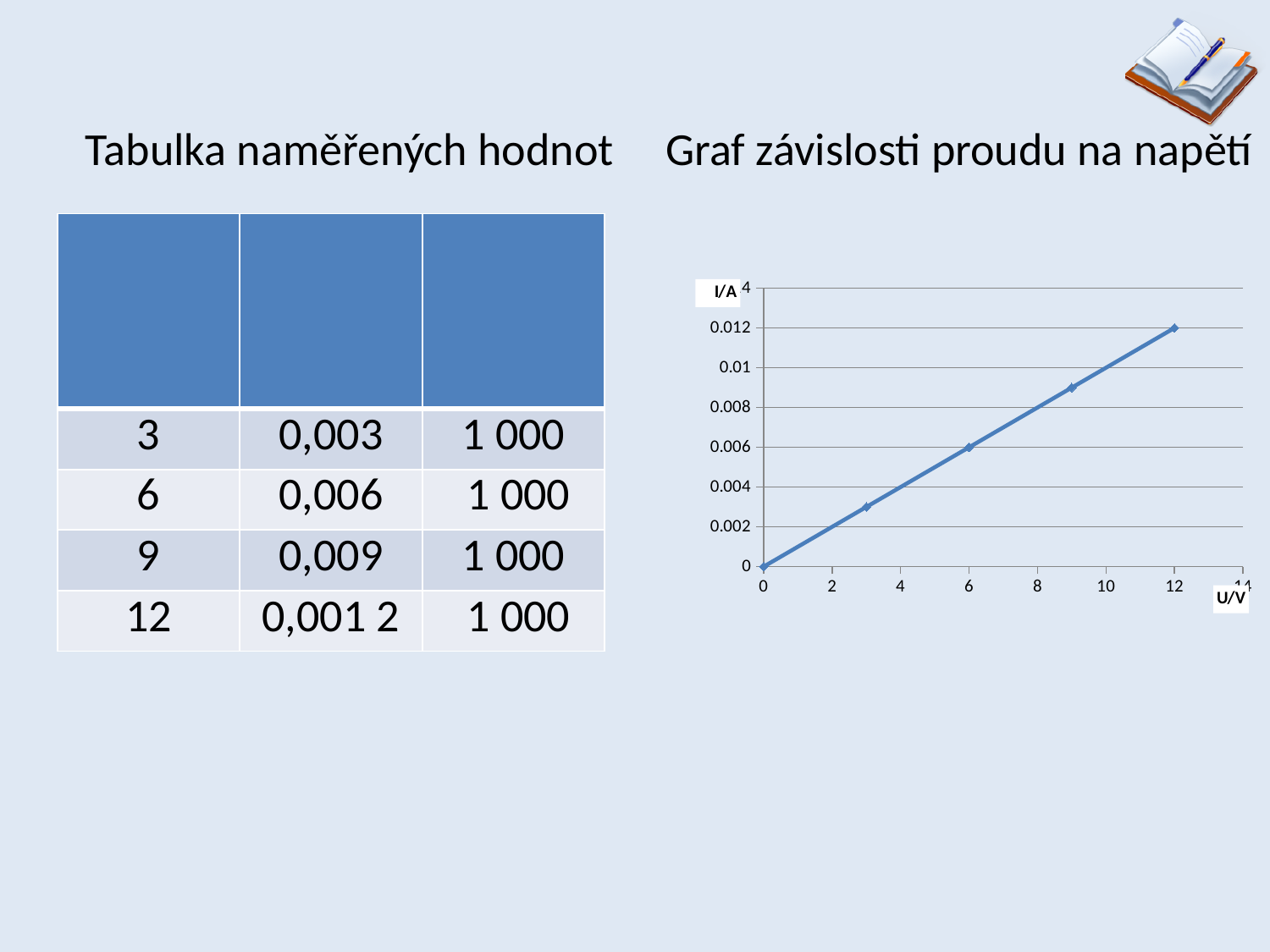
Is the value of I/A at U/V = 9 greater or less than 0.008? greater How many data points are plotted on the chart? 5 Is the value of I/A at U/V = 3 greater or less than 0.004? less What is the label of the vertical axis of the chart? I/A Do the plotted values rise or fall as U/V increases? rise What is the value of I/A at U/V = 12 on the chart? 0.012 What kind of chart is shown on the slide? line chart What is the title of the chart? Graf závislosti proudu na napětí What is the difference between the I/A values at U/V = 12 and U/V = 6? 0.006 At which U/V value is the plotted I/A highest? 12 What is the value of I/A at U/V = 6 on the chart? 0.006 What is the value of I/A at U/V = 0 on the chart? 0